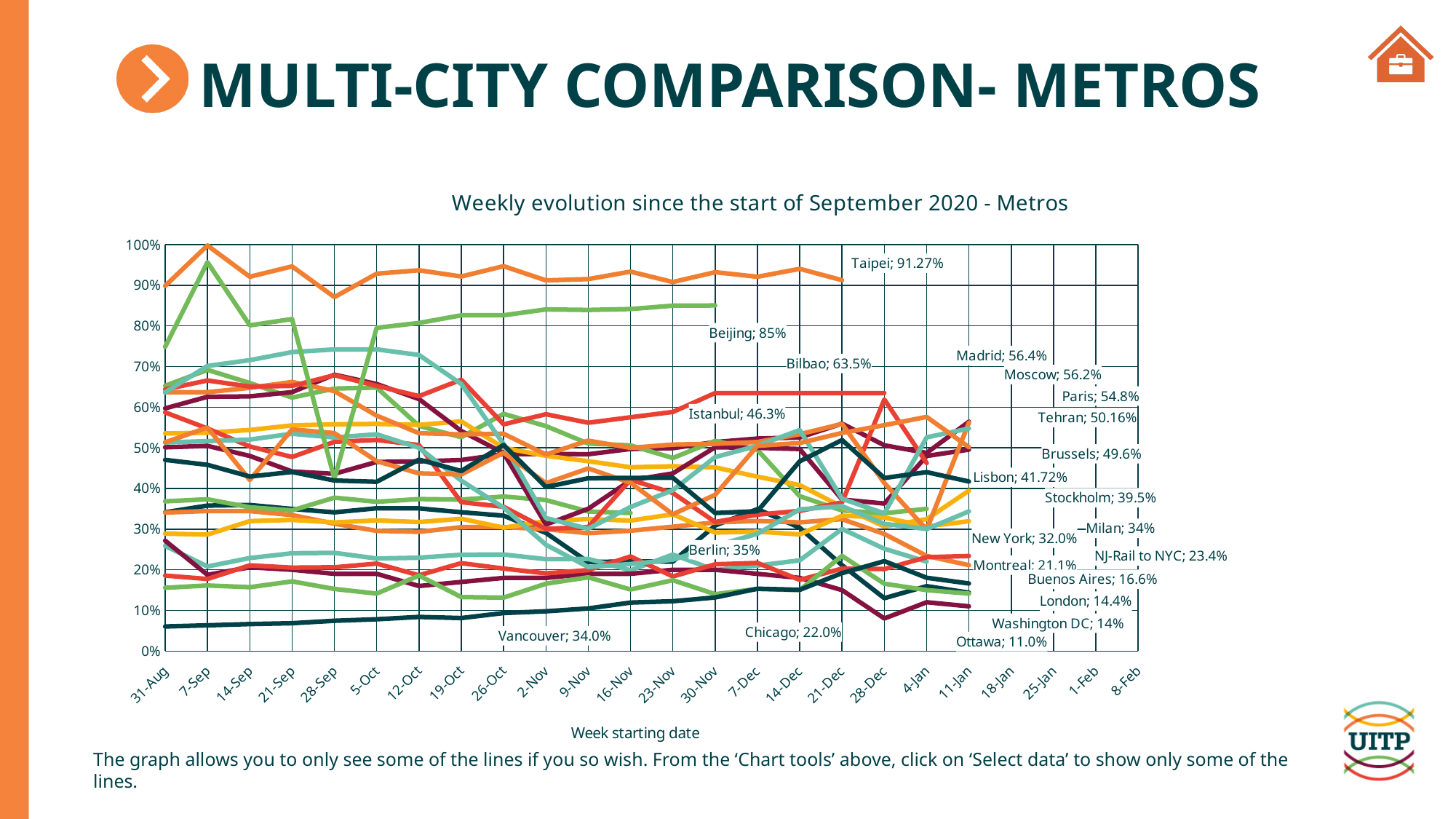
Which city has the lowest labelled value on the chart? Ottawa What kind of chart is shown on the slide? Line chart What is the labelled value for Beijing? 85% What is the difference between the labelled values for Taipei and Beijing? 6.27% What is the title of the chart? Weekly evolution since the start of September 2020 - Metros Which city has the highest labelled value on the chart? Taipei What is the labelled value for Taipei on the chart? 91.27% What is the labelled value for Lisbon? 41.72% What is the labelled value for Ottawa? 11.0% Is the Taipei line at 31-Aug greater or less than 80%? greater How many week-starting dates are labelled on the x axis? 24 Which has the larger labelled value, Paris or Tehran? Paris